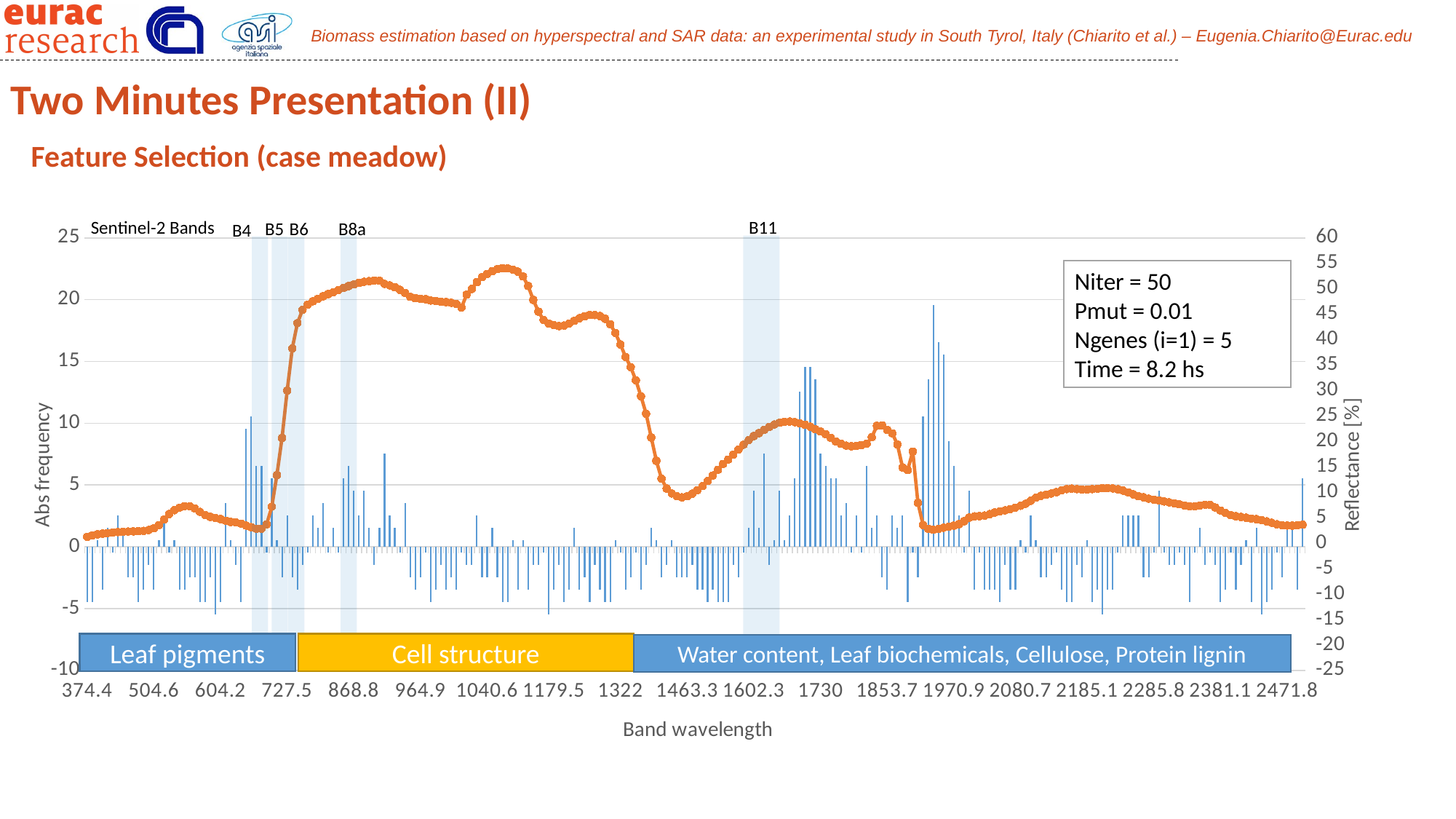
What is the title of the right vertical axis? Reflectance [%] Does the reflectance line rise or fall between the 1179.5 and 1463.3 wavelength labels? fall Does the reflectance line rise or fall between the 374.4 and 868.8 wavelength labels? rise Is the tallest Abs frequency bar greater or less than 15 on the left axis? greater What kind of chart is shown on the slide? A combination bar and line chart Is the reflectance value at the 1040.6 wavelength greater or less than 40? greater What is the title of the left vertical axis? Abs frequency Is the reflectance value at the 1322 wavelength greater or less than 20? greater How many Sentinel-2 bands are labelled as shaded regions on the chart? 5 Near which x-axis label does the reflectance line reach its highest value? 1040.6 Which Sentinel-2 band is highlighted near the 1602.3 wavelength label? B11